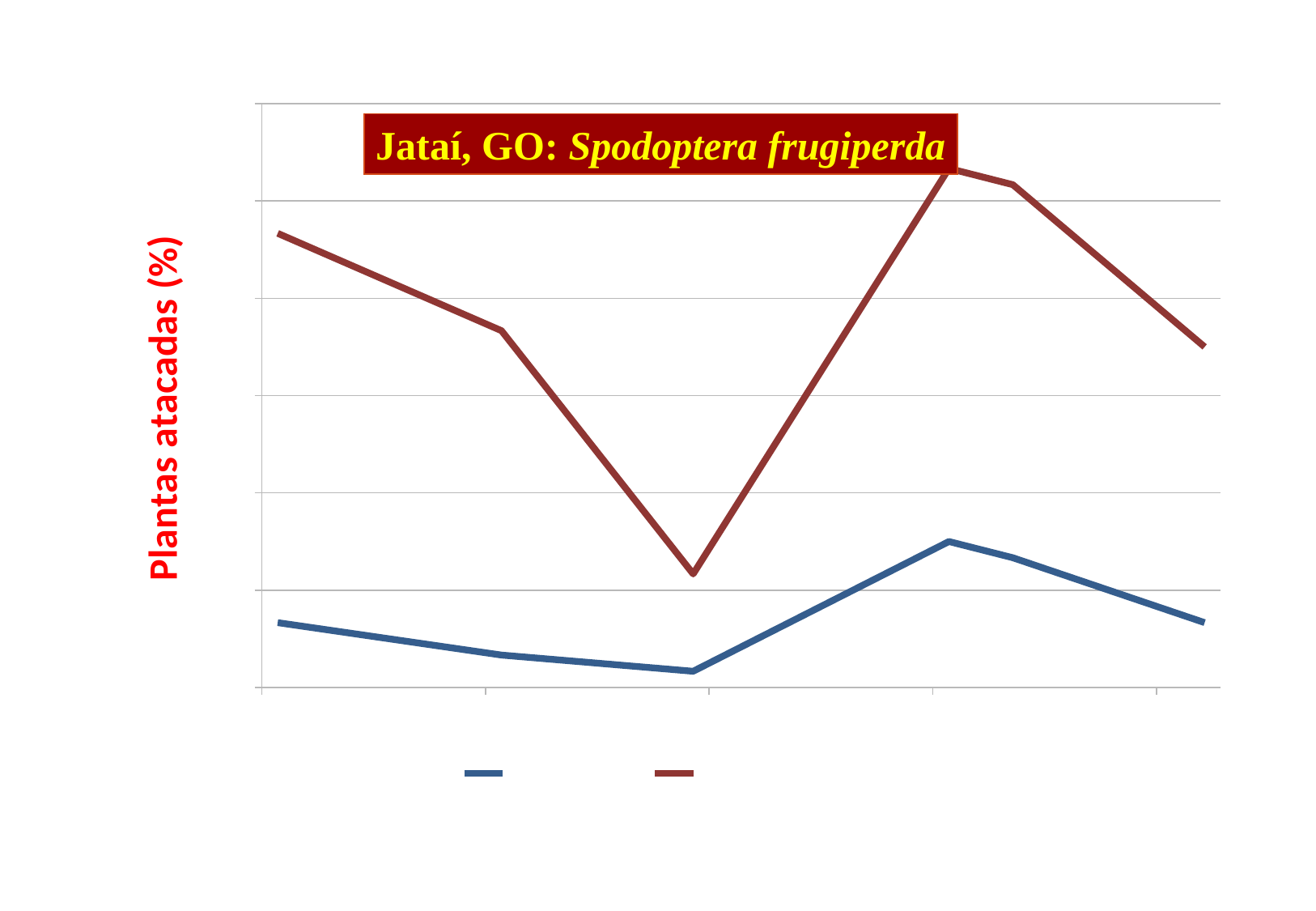
What is the label on the vertical axis? Plantas atacadas (%) Does the dark red line rise or fall between its first and third points? fall Does the dark red line rise or fall between its fourth and fifth points? fall Which line has higher values at every point, the blue line or the dark red line? dark red How many data points does each line have? 6 What is the title of the chart? Jataí, GO: Spodoptera frugiperda Does the blue line rise or fall between its third and fourth points? rise How many series does the legend list? 2 What kind of chart is shown on the slide? line chart